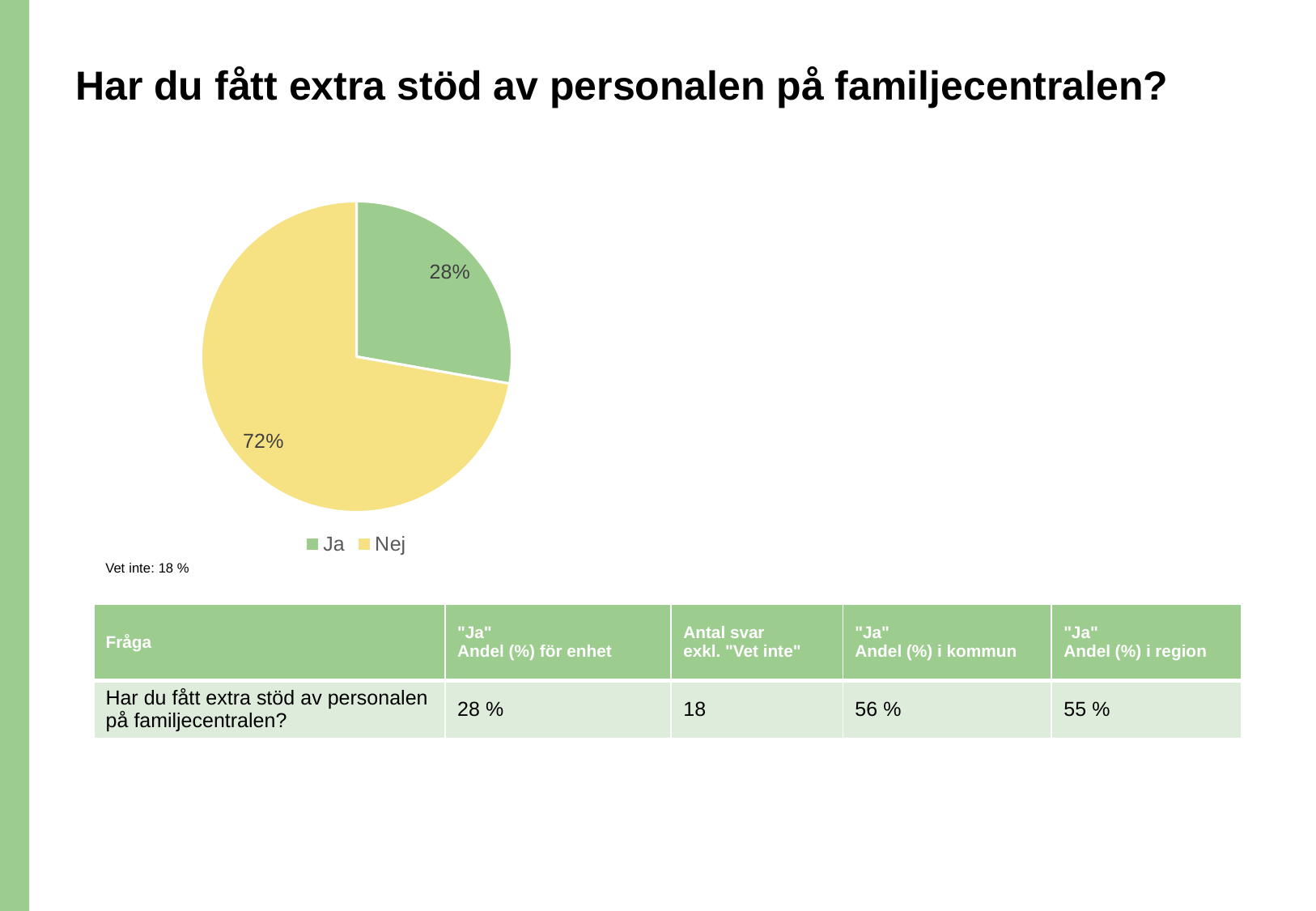
Is the share for "Nej" greater or less than 50%? greater What is the difference in percentage points between the "Nej" and "Ja" slices? 44 What colour is the "Nej" slice in the pie chart? yellow What share of the pie does "Nej" represent? 72% Which slice of the pie is the smallest? Ja Which slice of the pie is the largest? Nej What type of chart is shown on the slide? pie chart What colour is the "Ja" slice in the pie chart? green How many entries does the legend list? 2 Which is larger, the "Ja" slice or the "Nej" slice? Nej What share of the pie does "Ja" represent? 28% How many slices does the pie chart have? 2